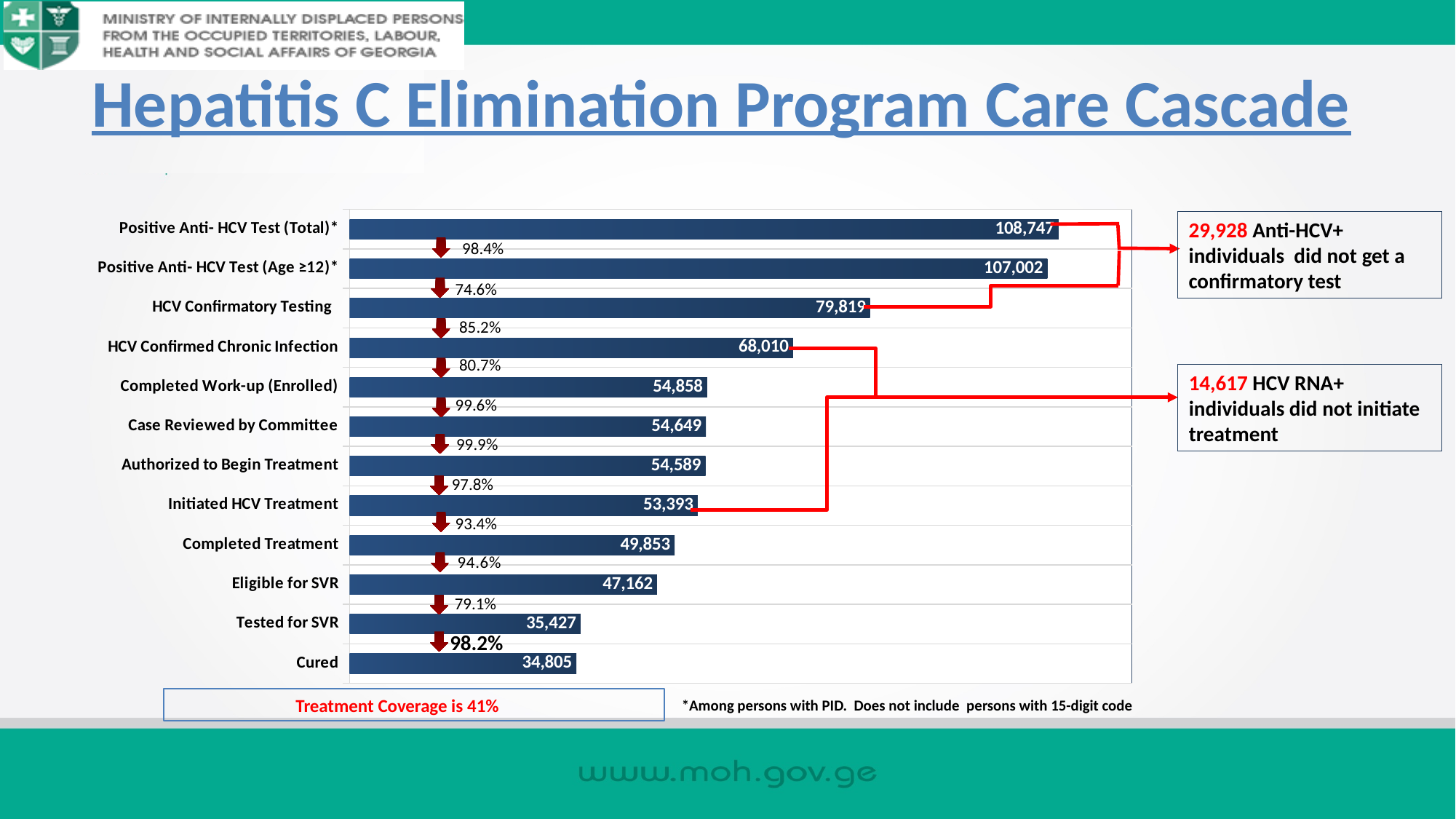
Which category has the lowest value in the chart? Cured What is the difference between Tested for SVR and Cured? 622 What is the value for Cured? 34,805 What is the value for Positive Anti-HCV Test (Total)? 108,747 How many categories (cascade steps) are plotted in the chart? 12 What is the value for HCV Confirmed Chronic Infection? 68,010 What is the difference between HCV Confirmed Chronic Infection and Initiated HCV Treatment? 14,617 Which is larger, Completed Treatment or Eligible for SVR? Completed Treatment What is the value for Tested for SVR? 35,427 Which category has the highest value in the chart? Positive Anti-HCV Test (Total) Do the bar values increase or decrease going from the top of the chart to the bottom? Decrease What kind of chart is shown on the slide? Bar chart